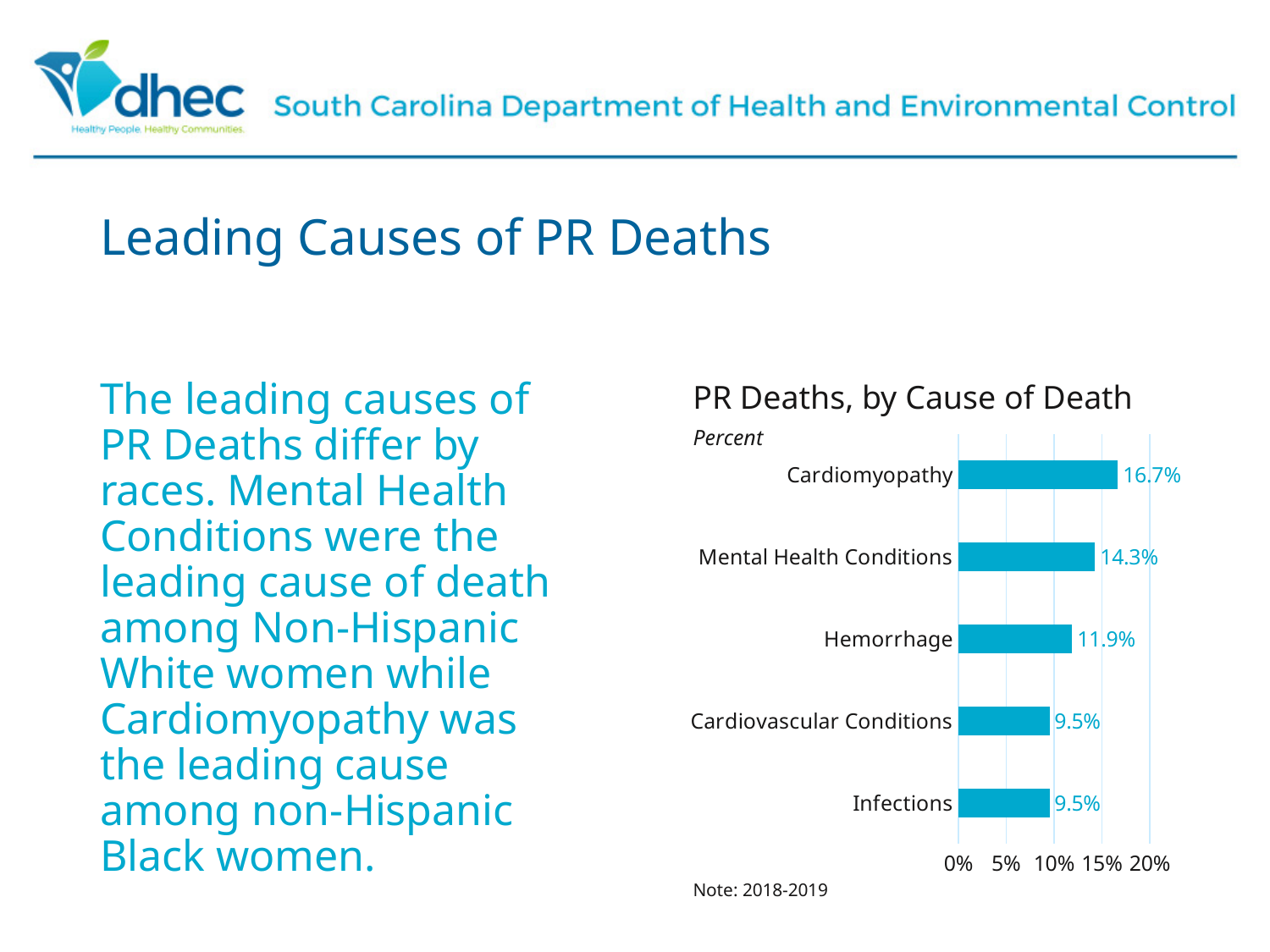
How many causes of death are shown in the chart? 5 What is the value for Hemorrhage? 11.9% Which cause of death has the highest percentage? Cardiomyopathy What is the difference between the values for Cardiomyopathy and Mental Health Conditions? 2.4% What is the title of the chart? PR Deaths, by Cause of Death What is the value for Infections? 9.5% What is the value for Cardiomyopathy? 16.7% What kind of chart is shown on the slide? Bar chart What is the difference between the values for Mental Health Conditions and Hemorrhage? 2.4% What is the value for Mental Health Conditions? 14.3% Which is larger, the value for Hemorrhage or the value for Cardiovascular Conditions? Hemorrhage Is the value for Cardiomyopathy greater or less than 15%? greater